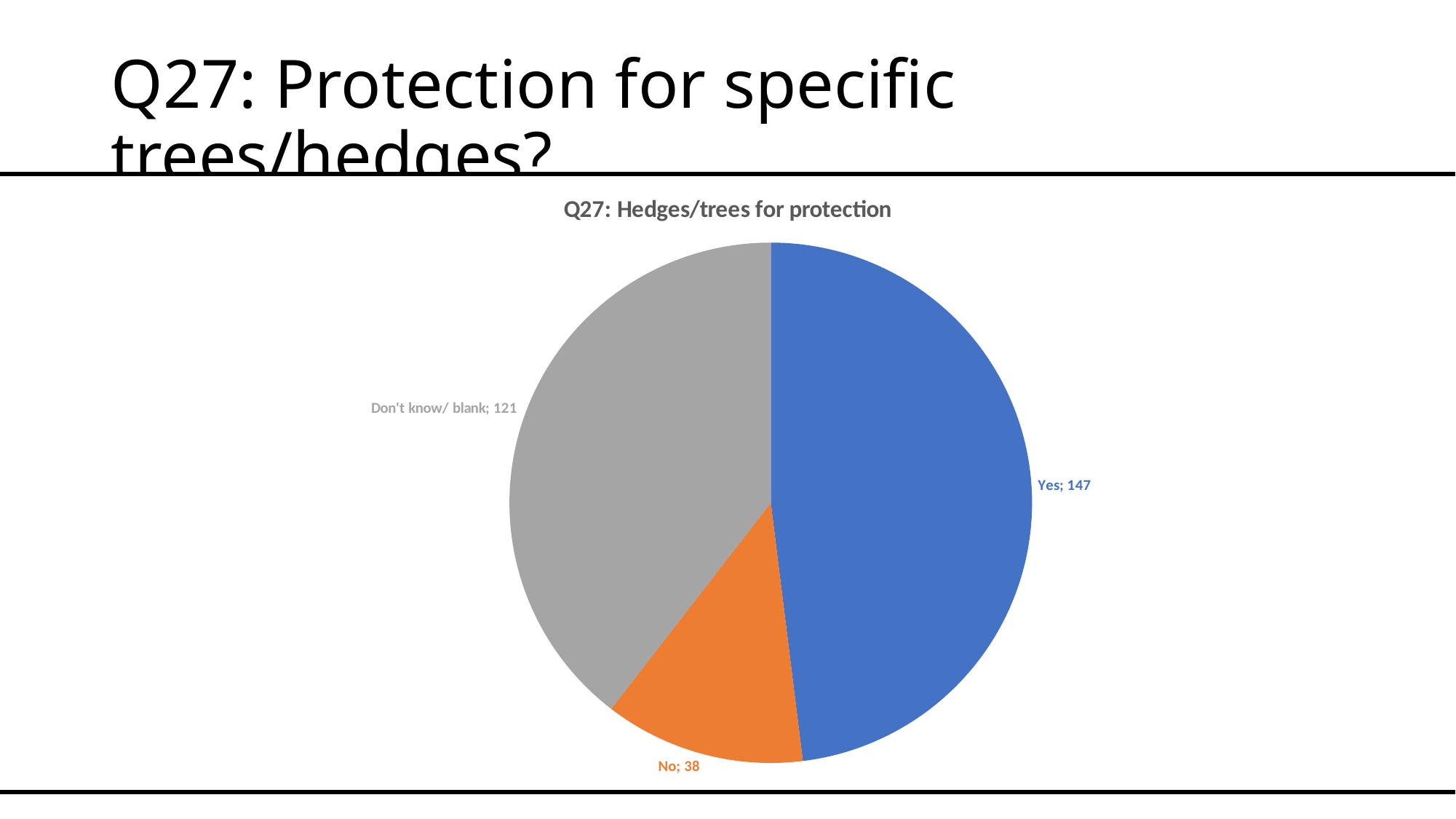
What is the difference between the Yes and Don't know/ blank values? 26 What is the title of the chart? Q27: Hedges/trees for protection What kind of chart is shown on the slide? Pie chart What is the difference between the Yes and No values? 109 What value is shown for the Don't know/ blank slice? 121 Which category has the smallest slice of the pie? No Which category has the largest slice of the pie? Yes What value is shown for the Yes slice? 147 Which is larger, the Don't know/ blank value or the No value? Don't know/ blank How many slices does the pie chart have? 3 What value is shown for the No slice? 38 What is the total of all three slice values? 306